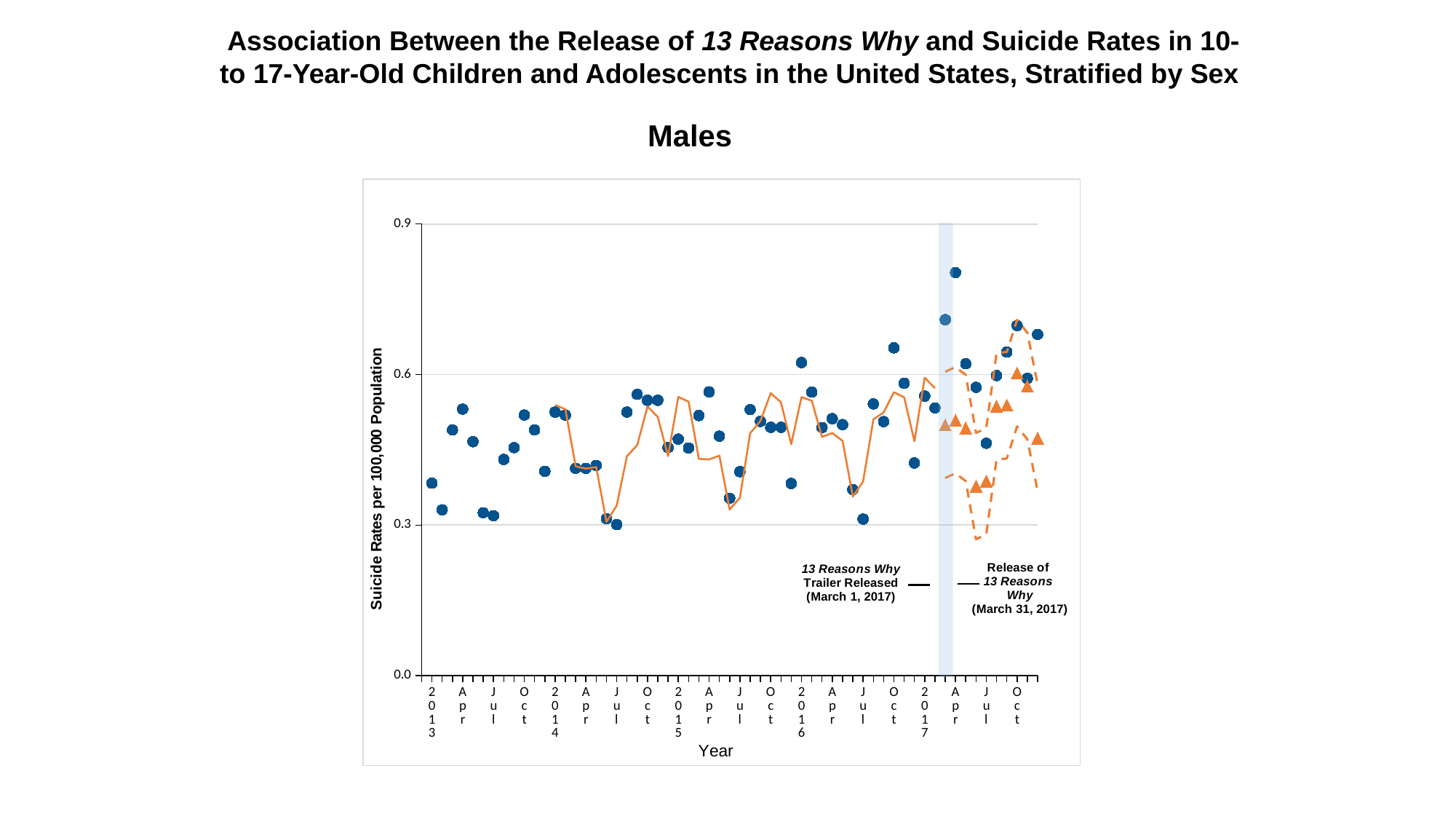
Is the plotted value for the first point in 2013 greater or less than 0.3? greater Which month has the highest plotted suicide rate for males? Apr 2017 Which is larger, the plotted value for April 2017 or the plotted value for the first point in 2013? April 2017 Do the plotted values generally rise or fall from 2013 to the end of 2017? rise What is the label of the vertical axis? Suicide Rates per 100,000 Population Is the plotted value for the first point in 2014 greater or less than 0.3? greater Is the plotted value for the last point in 2017 greater or less than 0.6? greater What is the highest value shown on the vertical axis? 0.9 What is the title shown directly above the chart? Males What kind of chart is shown on the slide? line chart